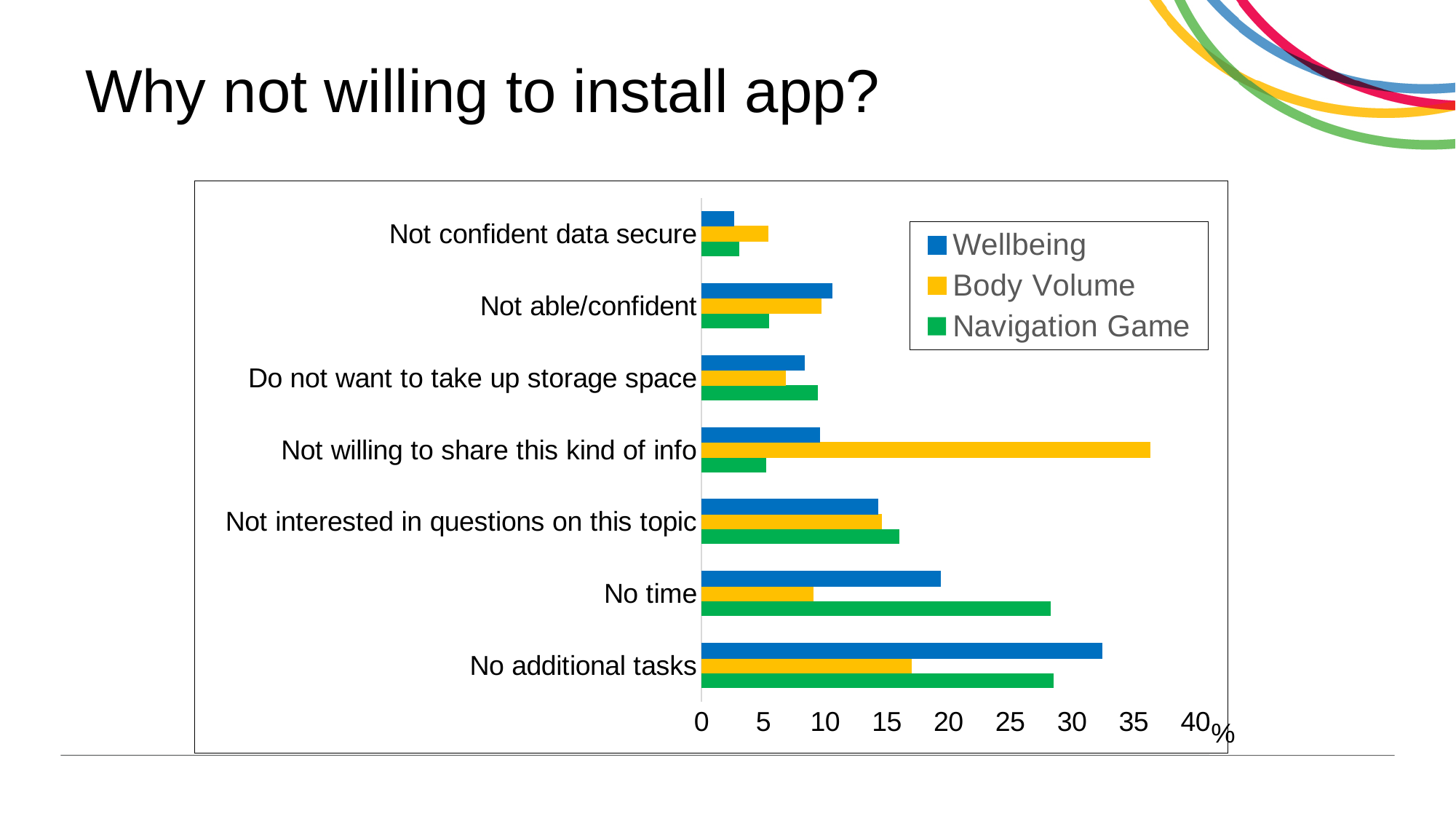
Is the Body Volume value for 'Not willing to share this kind of info' greater or less than 35? greater For 'Not willing to share this kind of info', which is larger: the Body Volume value or the Wellbeing value? Body Volume Is the Navigation Game value for 'No time' greater or less than 25? greater Is the Wellbeing value for 'No additional tasks' greater or less than 30? greater How many series does the legend list? 3 What kind of chart is shown on the slide? bar chart How many reason categories are plotted on the chart? 7 For the Wellbeing series, which category has the highest value? No additional tasks For the Wellbeing series, which category has the lowest value? Not confident data secure For 'No time', which is larger: the Wellbeing value or the Navigation Game value? Navigation Game For the Body Volume series, which category has the highest value? Not willing to share this kind of info What colour represents the Body Volume series in the legend? yellow